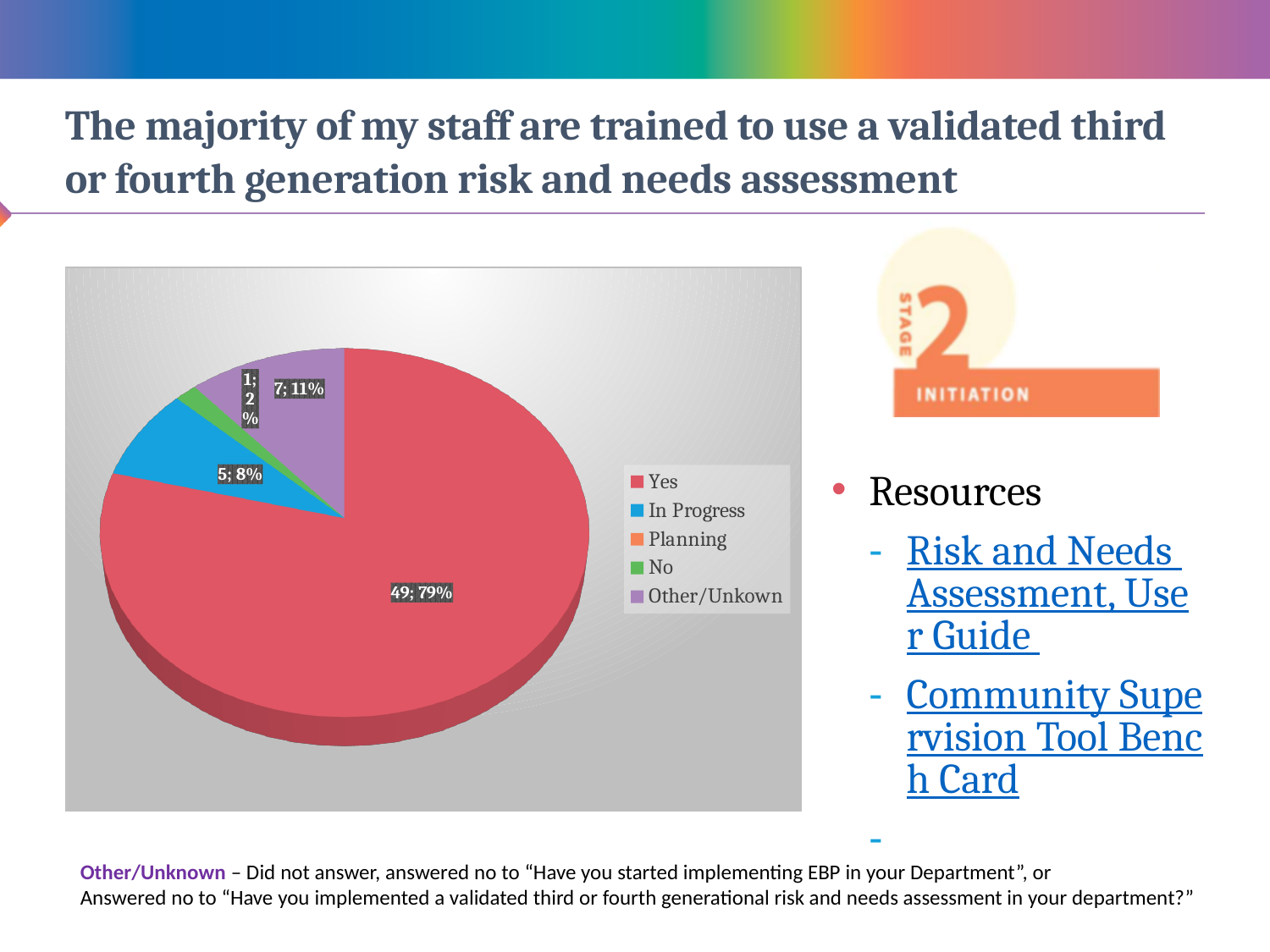
What percentage of the pie does the "No" slice represent? 2% What kind of chart is shown on the slide? Pie chart What is the difference in count between the "Yes" slice and the "Other/Unkown" slice? 42 How many responses are in the "Other/Unkown" slice? 7 What percentage of the pie does the "Other/Unkown" slice represent? 11% Which slice is larger, "In Progress" or "Other/Unkown"? Other/Unkown How many responses are in the "Yes" slice? 49 How many responses are in the "In Progress" slice? 5 Which of the labelled slices is the smallest? No Which category has the largest slice of the pie? Yes What percentage of the pie does the "Yes" slice represent? 79% How many entries does the chart's legend list? 5